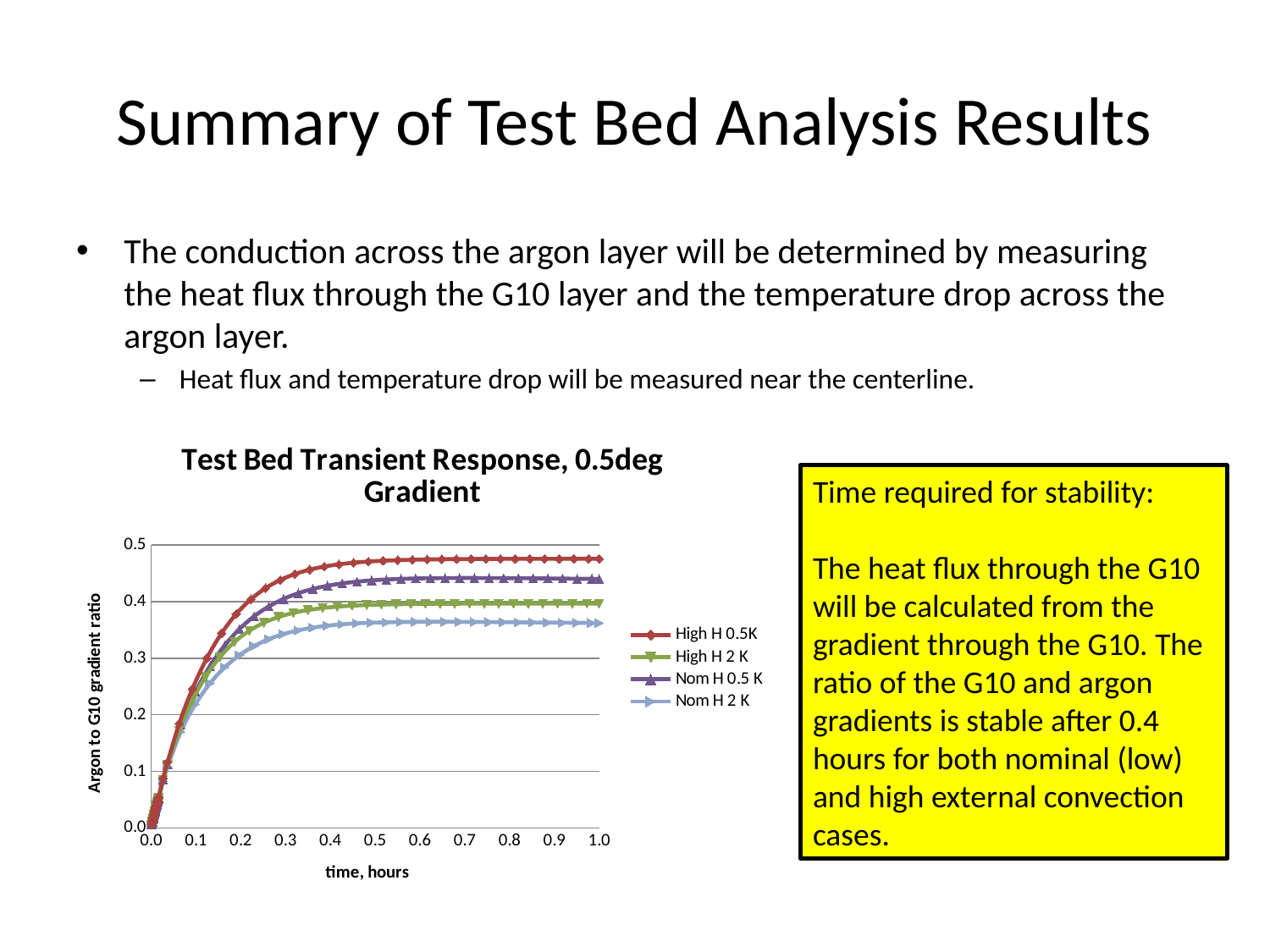
Is the value for High H 0.5K at 0.2 hours greater or less than 0.3? greater How many series does the chart legend list? 4 Is the value for Nom H 2 K at 1.0 hours greater or less than 0.4? less What is the title of the chart? Test Bed Transient Response, 0.5deg Gradient Which series has the lowest value at 1.0 hours? Nom H 2 K Which series has the highest value at 1.0 hours? High H 0.5K Is the value for High H 0.5K at 1.0 hours greater or less than 0.4? greater At 0.5 hours, which is larger: High H 0.5K or Nom H 2 K? High H 0.5K Do the values of the High H 0.5K series rise or fall as time increases from 0.0 to 0.4 hours? rise What kind of chart is shown on the slide? line chart What is the label of the x axis of the chart? time, hours